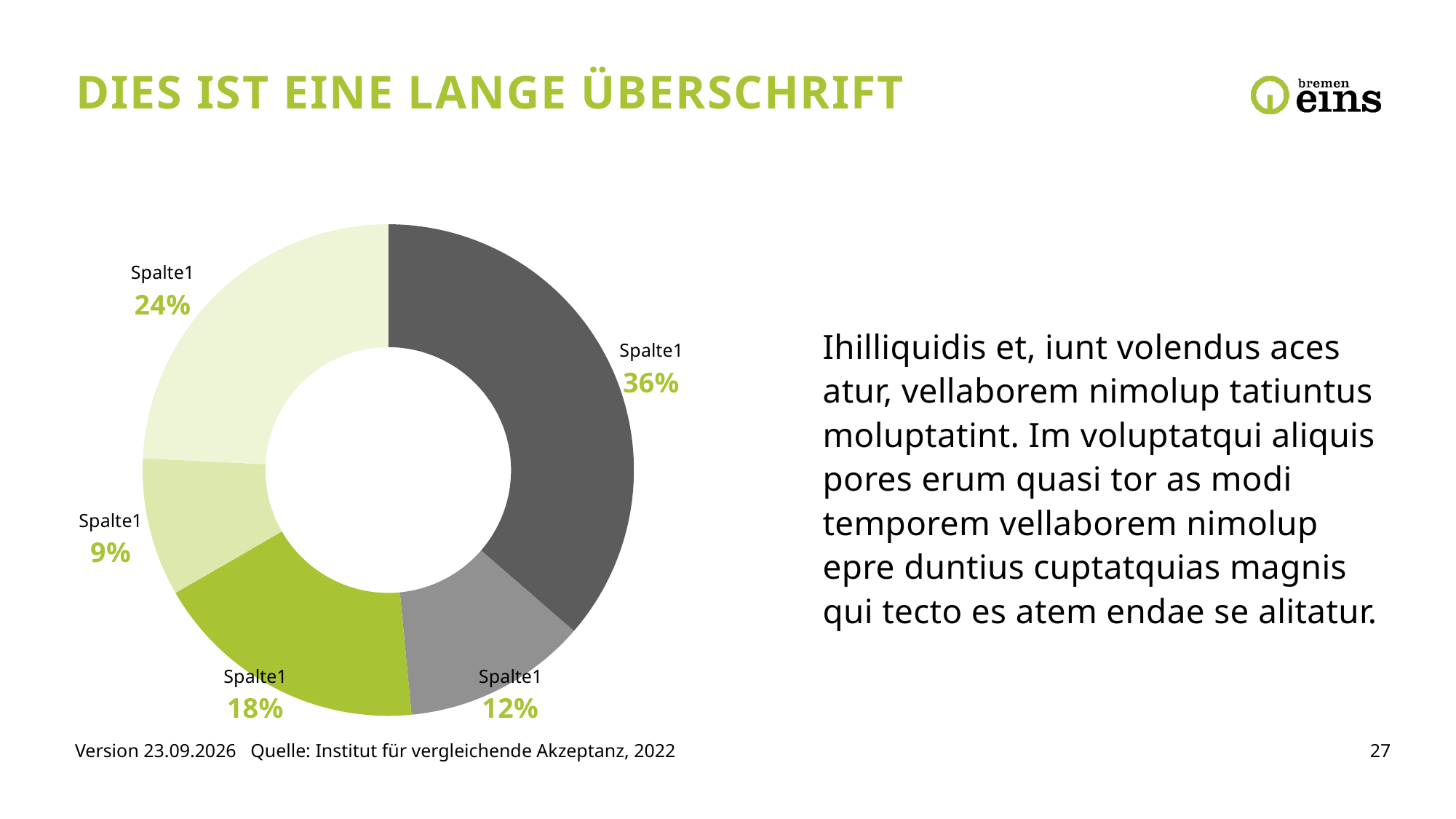
What percentage is shown for the bright green slice at the bottom left of the doughnut chart? 18% What kind of chart is shown on the slide? Doughnut (pie) chart What is the difference in percentage points between the dark grey slice (36%) and the medium grey slice (12%)? 24 percentage points What percentage is shown for the medium grey slice at the bottom right of the doughnut chart? 12% Which is larger: the pale green slice at the top left or the bright green slice at the bottom left? The pale green slice (24%) What label is used for every slice of the doughnut chart? Spalte1 Which slice has the largest share in the doughnut chart? The dark grey slice (36%) What percentage is shown for the small light green slice on the left of the doughnut chart? 9% Which slice has the smallest share in the doughnut chart? The light green slice (9%) What percentage is shown for the pale green slice at the top left of the doughnut chart? 24% What percentage is shown for the dark grey slice of the doughnut chart? 36% How many slices does the doughnut chart have? 5